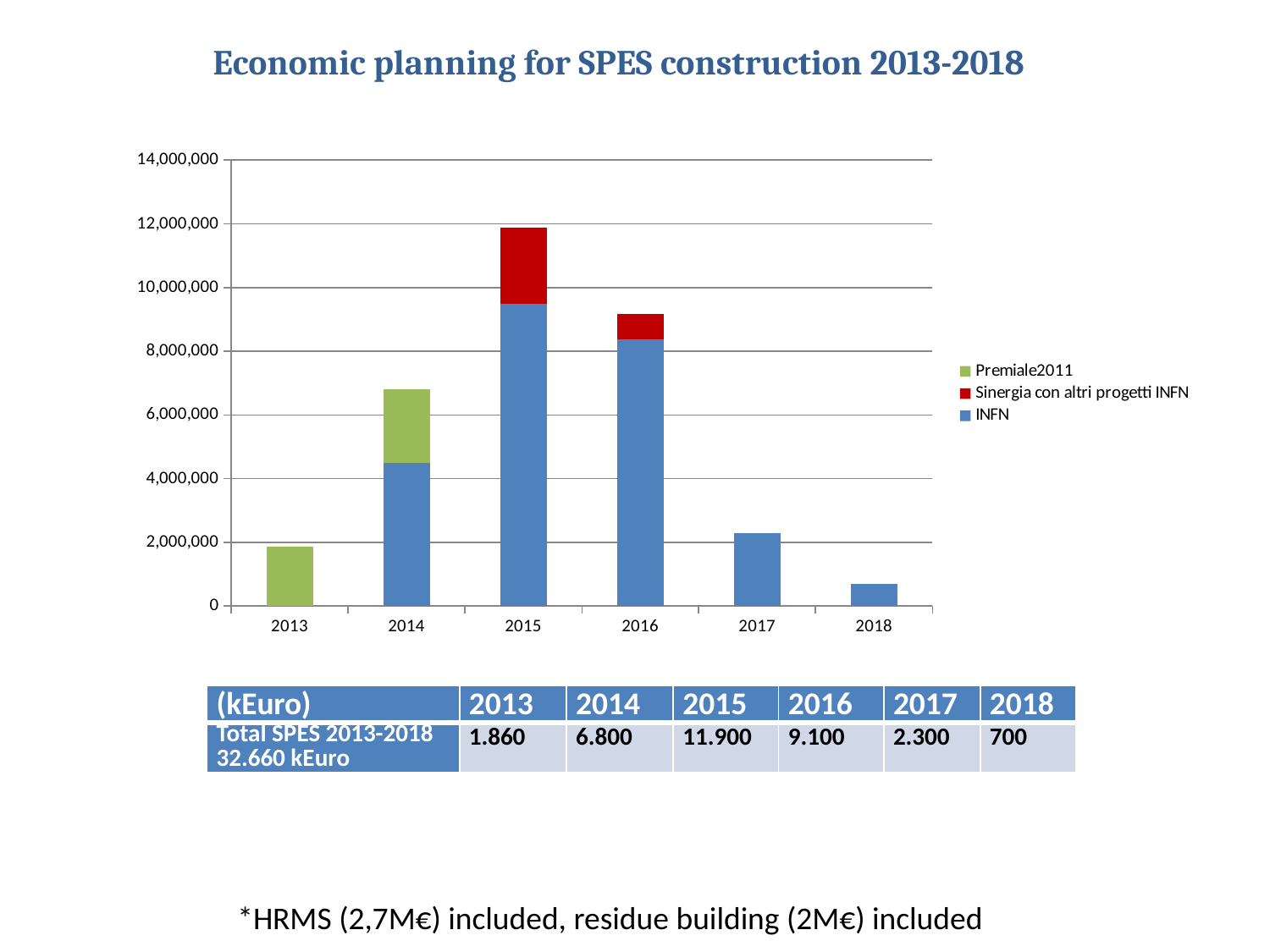
Which series is shown in green in the legend? Premiale2011 Which year has the shortest bar? 2018 How many years are shown on the x axis of the chart? 6 Is the total value of the bar for 2015 greater or less than 10,000,000? greater Which stacked bar is taller, 2014 or 2016? 2016 Which year has the tallest stacked bar? 2015 What kind of chart is shown on the slide? bar chart Which years include the red 'Sinergia con altri progetti INFN' segment? 2015 and 2016 According to the table below the chart, what is the total for 2015 in kEuro? 11.900 Is the value for 2017 greater or less than 4,000,000? less How many series does the legend list? 3 Is the value for 2013 greater or less than 2,000,000? less